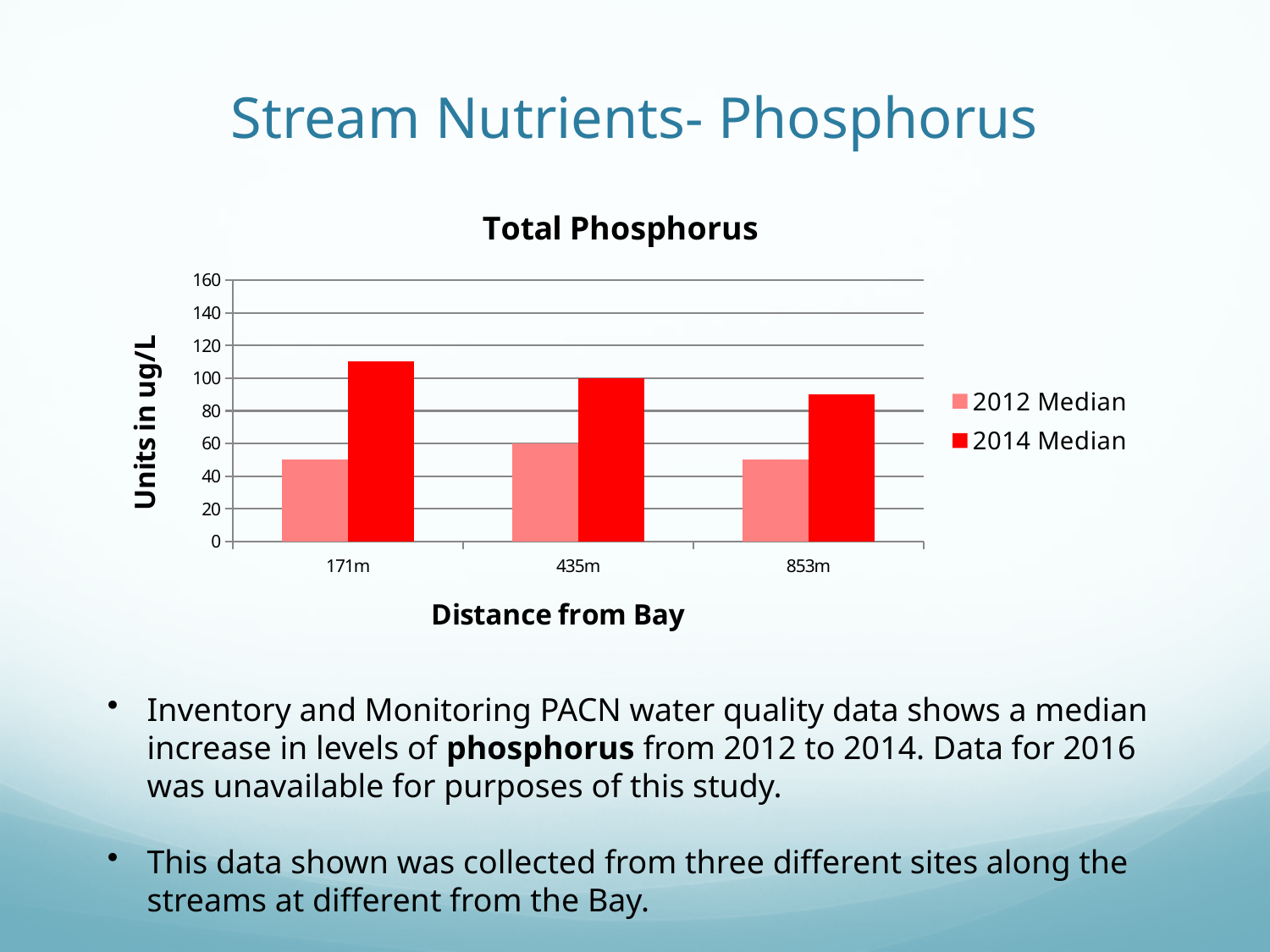
How many series does the legend list? 2 Is the 2014 Median value at 853m greater or less than 80? greater Is the 2014 Median value at 171m greater or less than 100? greater Which distance from the bay has the highest 2014 Median value? 171m At 435m, which is larger, the 2012 Median or the 2014 Median? 2014 Median Do the 2014 Median values rise or fall as distance from the bay increases? fall Which distance from the bay has the highest 2012 Median value? 435m How many distance categories are shown on the x axis? 3 What kind of chart is shown on the slide? Bar chart Which distance from the bay has the lowest 2014 Median value? 853m What is the label on the y axis of the chart? Units in ug/L Is the 2012 Median value at 853m greater or less than 60? less